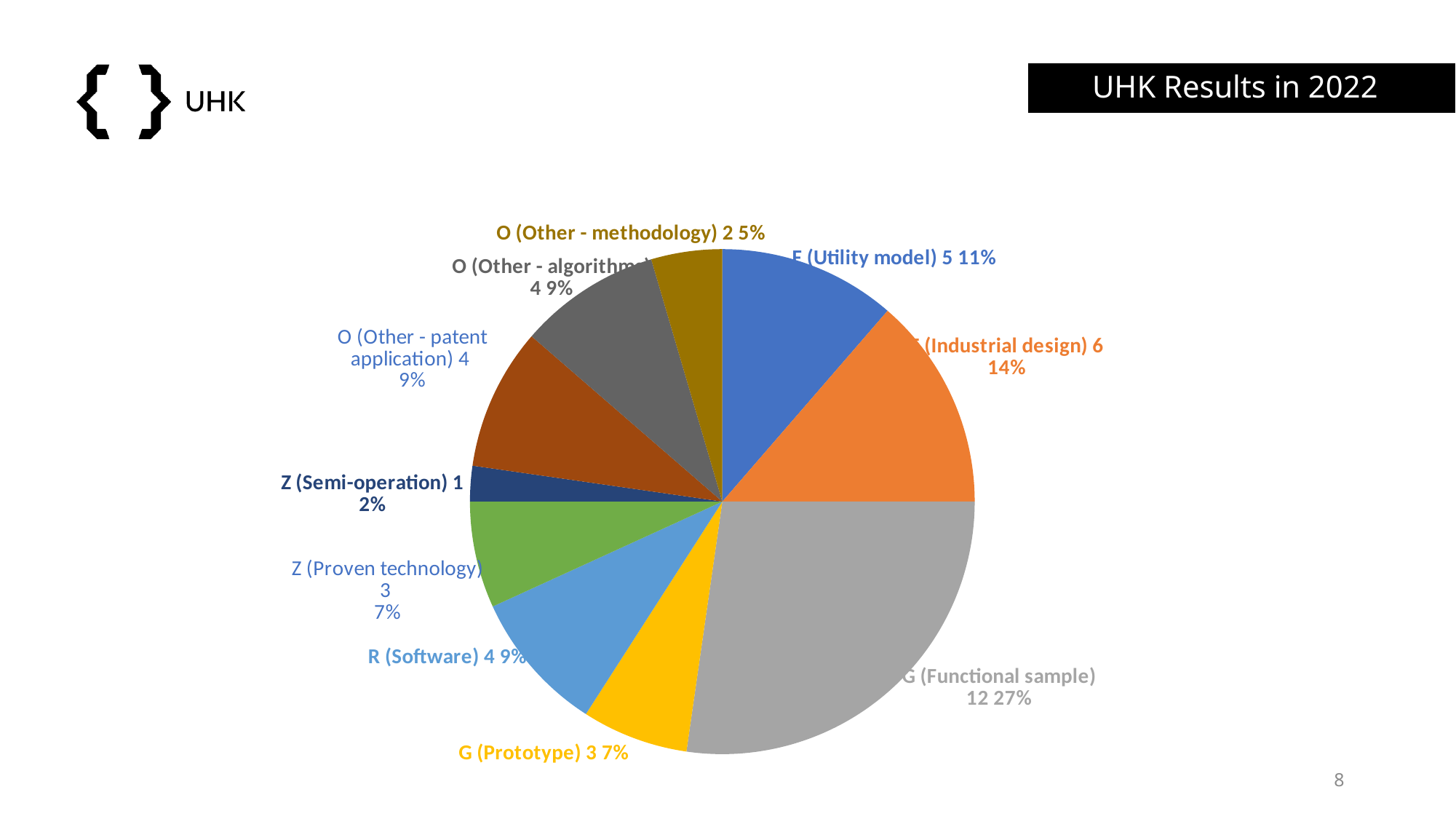
How many slices does the pie chart have? 10 Which category has the smallest slice of the pie? Z (Semi-operation) Which is larger, the count for R (Software) or the count for G (Prototype)? R (Software) What is the count shown for Z (Proven technology)? 3 Which category has the largest slice of the pie? G (Functional sample) What is the count shown for F (Utility model)? 5 What is the count shown for G (Functional sample)? 12 What percentage share does F (Industrial design) have? 14% What percentage share does O (Other - methodology) have? 5% What is the title shown in the black box at the top right of the slide? UHK Results in 2022 What is the difference between the counts for G (Functional sample) and F (Industrial design)? 6 What kind of chart is shown on the slide? pie chart